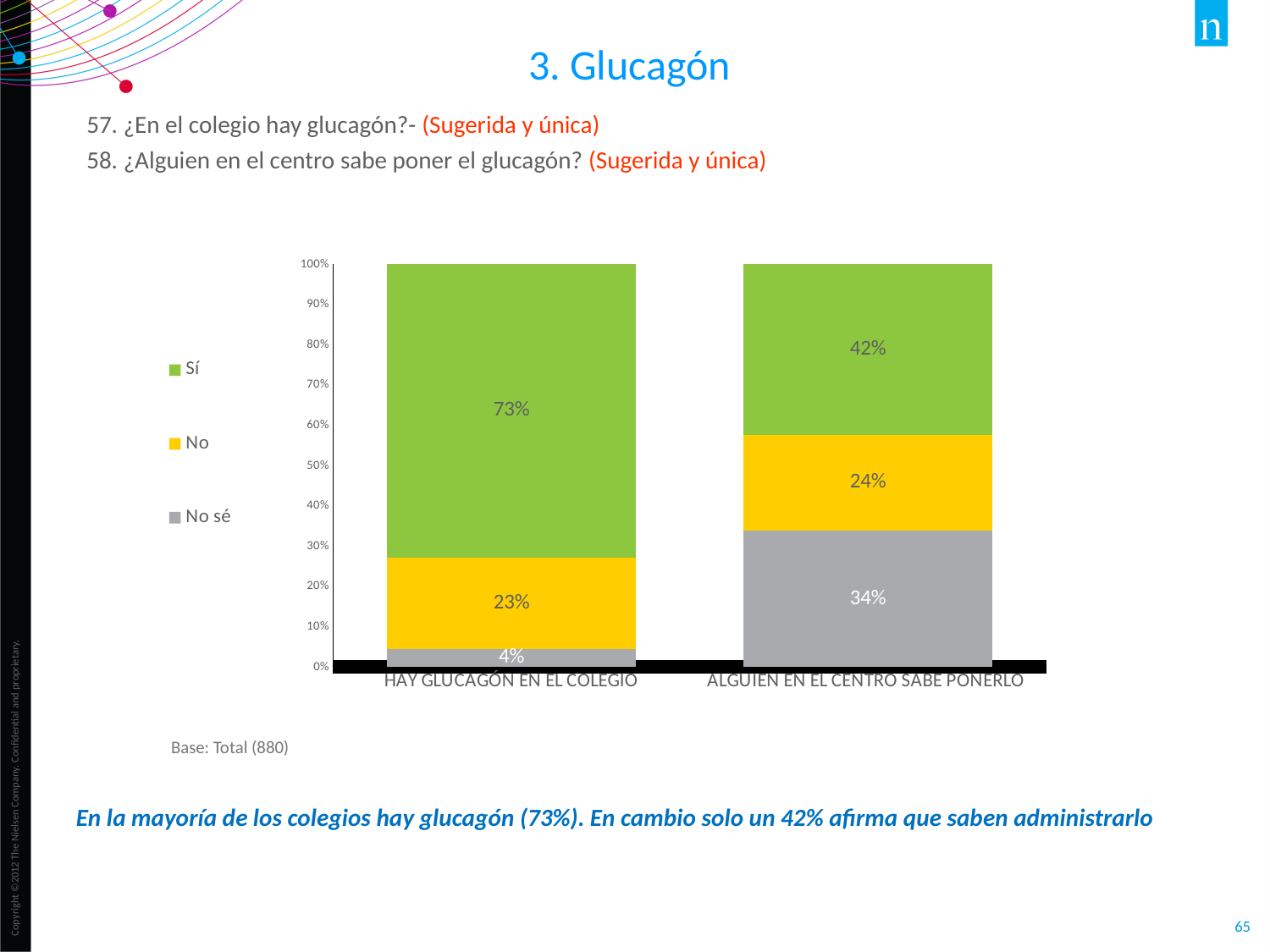
What percentage answered "No sé" for "ALGUIEN EN EL CENTRO SABE PONERLO"? 34% How many series does the chart legend list? 3 How many categories are shown on the x axis of the chart? 2 Which category has the higher "Sí" percentage? HAY GLUCAGÓN EN EL COLEGIO What percentage answered "Sí" for "ALGUIEN EN EL CENTRO SABE PONERLO"? 42% What is the difference between the "Sí" percentages for "HAY GLUCAGÓN EN EL COLEGIO" and "ALGUIEN EN EL CENTRO SABE PONERLO"? 31% Which colour represents "No sé" in the chart? Grey What kind of chart is shown on the slide? Stacked bar chart Is the "No" percentage larger for "HAY GLUCAGÓN EN EL COLEGIO" or for "ALGUIEN EN EL CENTRO SABE PONERLO"? ALGUIEN EN EL CENTRO SABE PONERLO What percentage answered "No" for "HAY GLUCAGÓN EN EL COLEGIO"? 23% Which category has the lower "No sé" percentage? HAY GLUCAGÓN EN EL COLEGIO What percentage answered "Sí" for "HAY GLUCAGÓN EN EL COLEGIO"? 73%